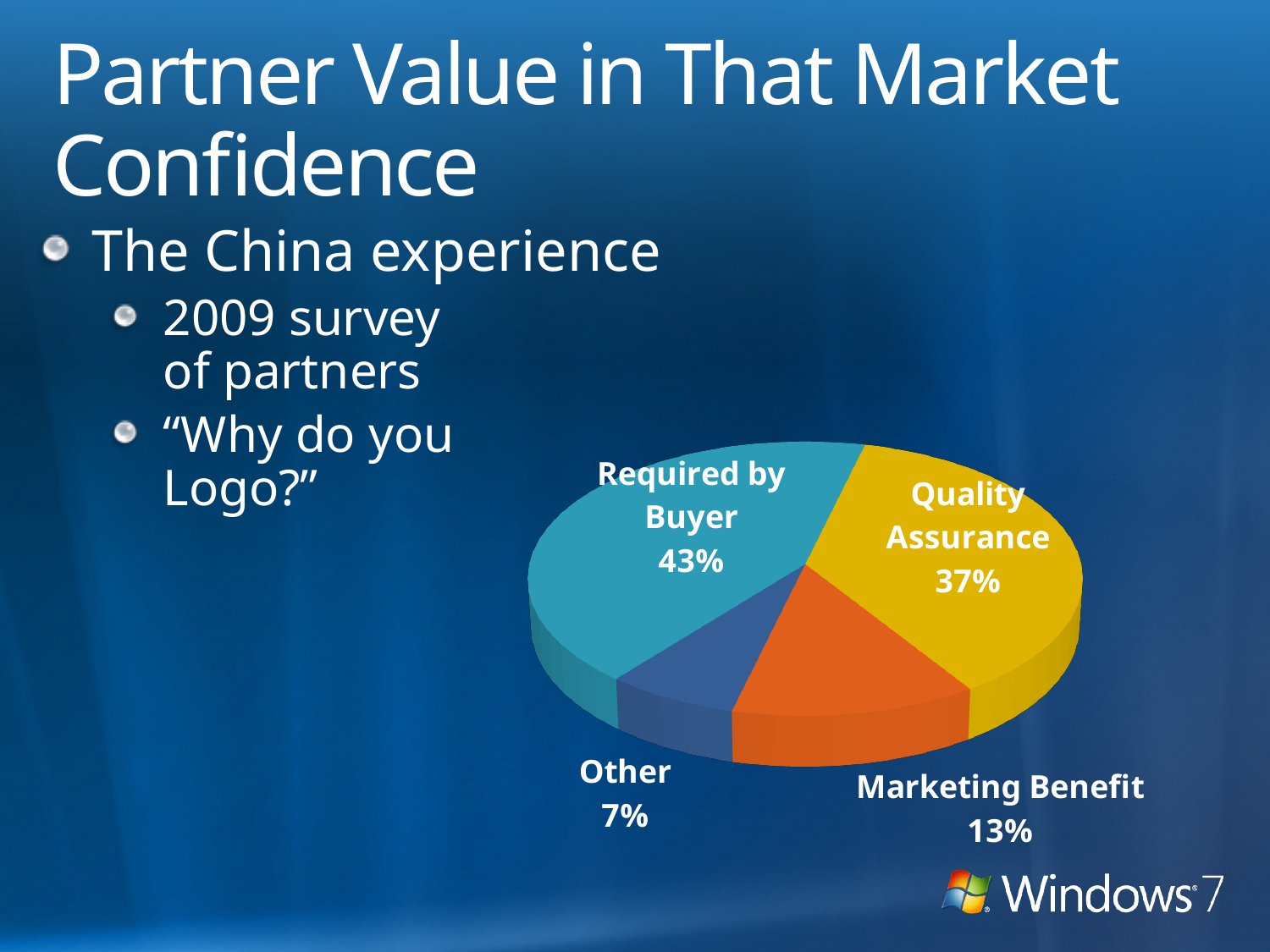
What percentage of the pie is labelled Quality Assurance? 37% Which slice of the pie is the largest? Required by Buyer How many slices does the pie chart have? 4 What is the combined share of Marketing Benefit and Other? 20% What is the difference in percentage points between Required by Buyer and Quality Assurance? 6 What percentage of the pie is labelled Required by Buyer? 43% What percentage of the pie is labelled Marketing Benefit? 13% What percentage of the pie is labelled Other? 7% Which slice of the pie is the smallest? Other What colour is the Quality Assurance slice? yellow What kind of chart is shown on the slide? pie chart Which is larger, Marketing Benefit or Other? Marketing Benefit